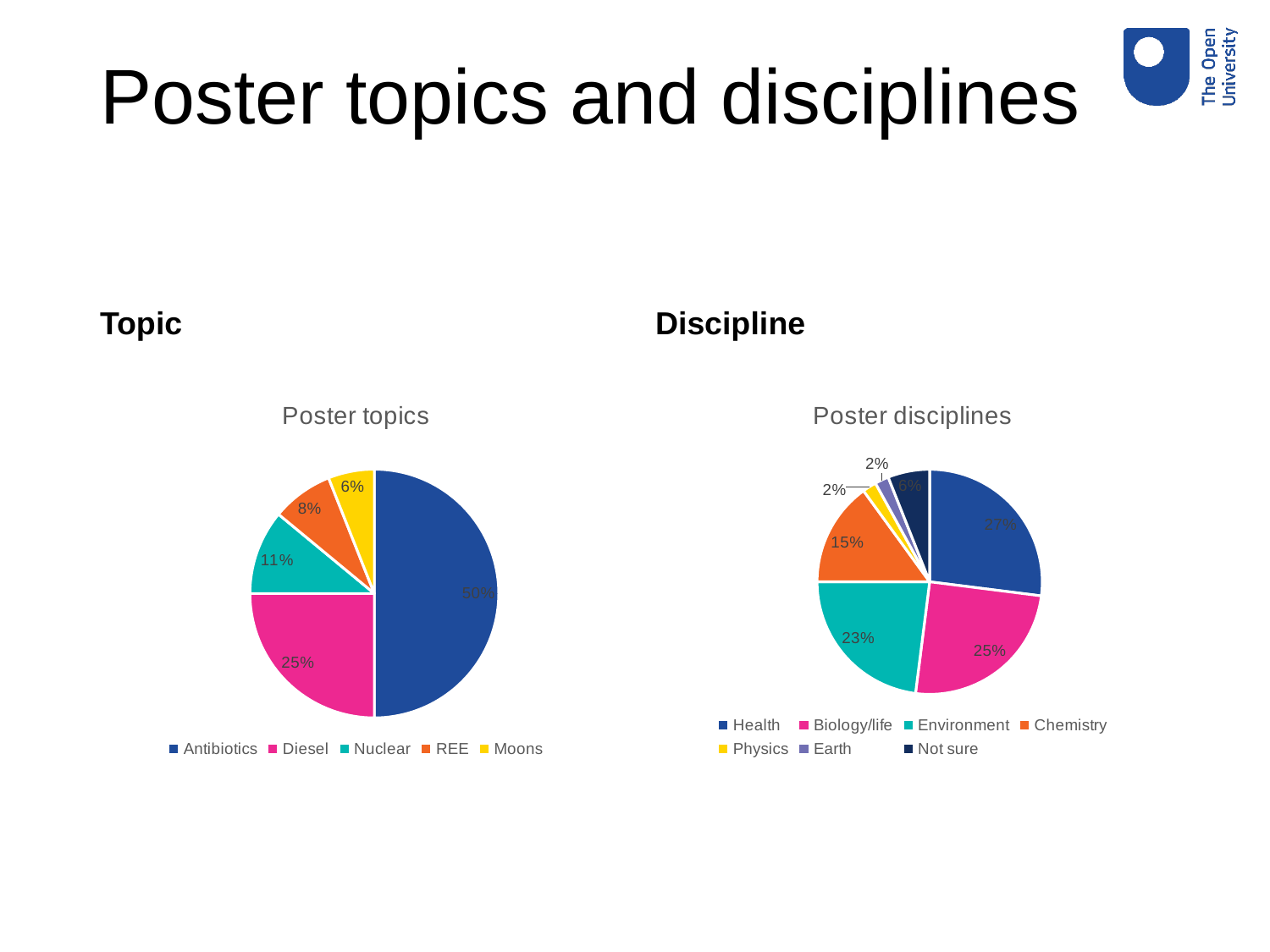
In the Poster disciplines chart, which discipline has the largest slice? Health In the Poster disciplines chart, which is larger, Biology/life or Environment? Biology/life In the Poster disciplines chart, what colour is the Environment slice? Teal What kind of chart is the Poster disciplines chart? Pie chart How many categories does the legend of the Poster disciplines chart list? 7 In the Poster topics chart, what is the value for Nuclear? 11% In the Poster topics chart, which topic has the smallest slice? Moons How many categories does the Poster topics chart show? 5 In the Poster topics chart, what is the difference between the Diesel and REE shares? 17% In the Poster disciplines chart, what is the value for Chemistry? 15% In the Poster topics chart, what share of the pie is Antibiotics? 50% In the Poster disciplines chart, what is the value for Environment? 23%